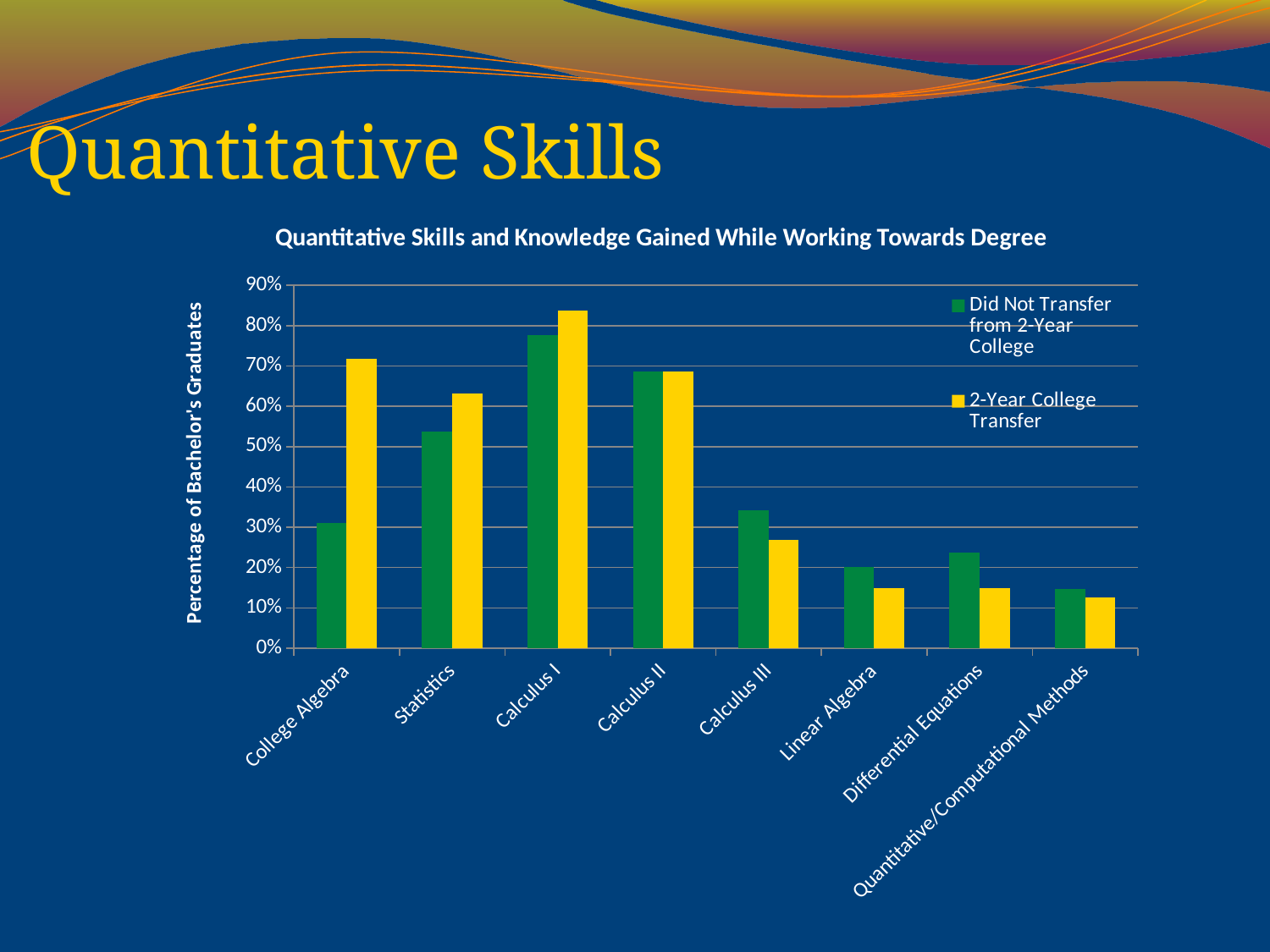
How many course categories are shown on the x axis? 8 Which category has the highest value for the 2-Year College Transfer series? Calculus I For Calculus III, which series has the larger value? Did Not Transfer from 2-Year College What is the title of the chart? Quantitative Skills and Knowledge Gained While Working Towards Degree Is the value for Did Not Transfer from 2-Year College in College Algebra greater or less than 40%? less What kind of chart is shown on the slide? bar chart How many series does the legend list? 2 Is the value for 2-Year College Transfer in Linear Algebra greater or less than 20%? less For College Algebra, which series has the larger value? 2-Year College Transfer Which category has the highest value for the Did Not Transfer from 2-Year College series? Calculus I Is the value for 2-Year College Transfer in Calculus I greater or less than 80%? greater Which category has the lowest value for the 2-Year College Transfer series? Quantitative/Computational Methods